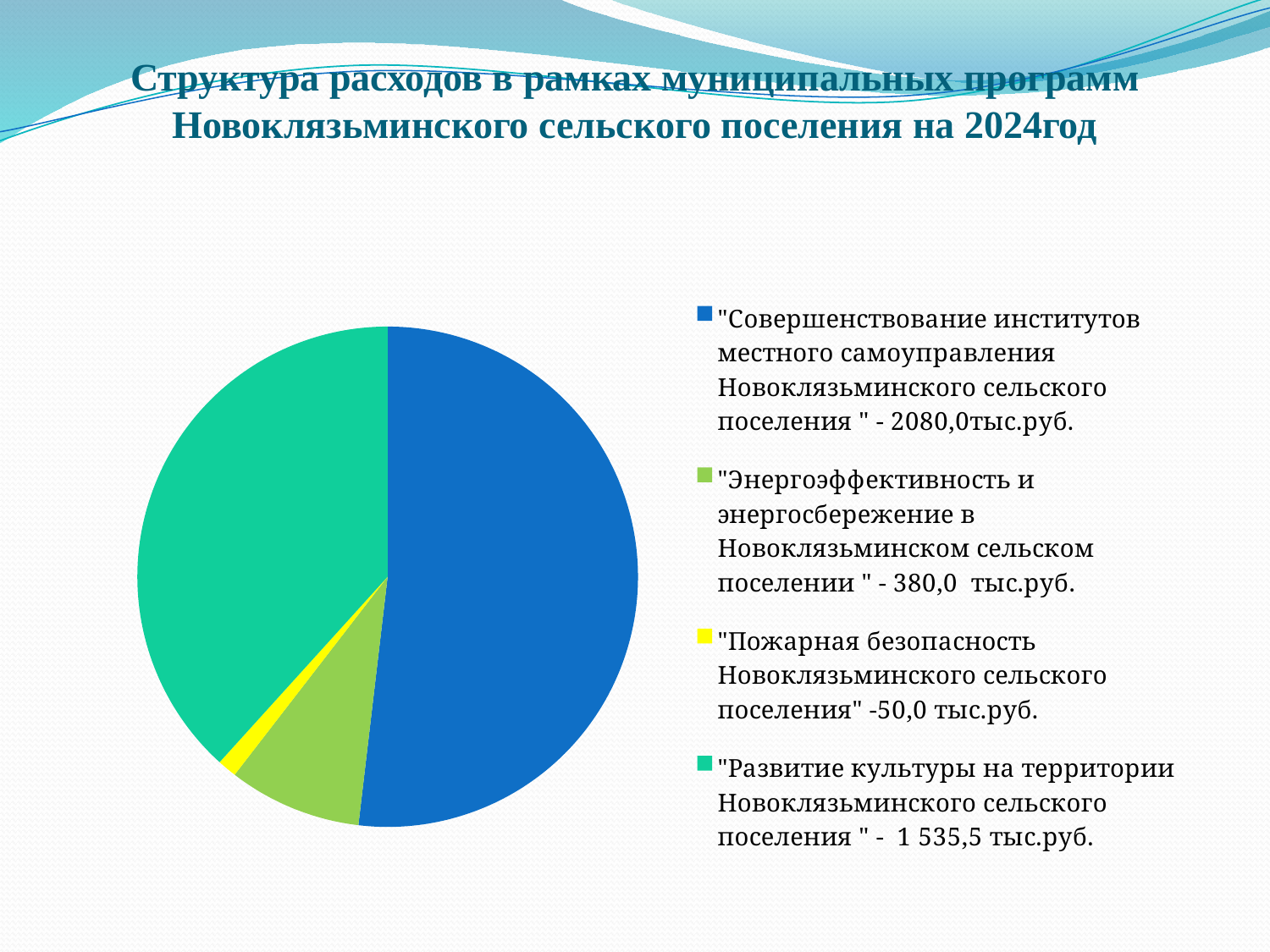
What is the value for "Энергоэффективность и энергосбережение"? 380,0 тыс.руб. What is the difference between the expenditure on "Совершенствование институтов местного самоуправления" and on "Развитие культуры"? 544,5 тыс.руб. Which program has the smallest expenditure? Пожарная безопасность Which is larger: the expenditure on "Энергоэффективность и энергосбережение" or on "Пожарная безопасность"? Энергоэффективность и энергосбережение What is the value for "Пожарная безопасность"? 50,0 тыс.руб. Which program has the largest expenditure? Совершенствование институтов местного самоуправления How many entries does the legend list? 4 What colour is the slice for "Развитие культуры на территории Новоклязьминского сельского поселения"? Green What is the value for "Развитие культуры на территории Новоклязьминского сельского поселения"? 1 535,5 тыс.руб. What kind of chart is shown on the slide? Pie chart How many slices does the pie chart have? 4 What is the value for "Совершенствование институтов местного самоуправления"? 2080,0 тыс.руб.